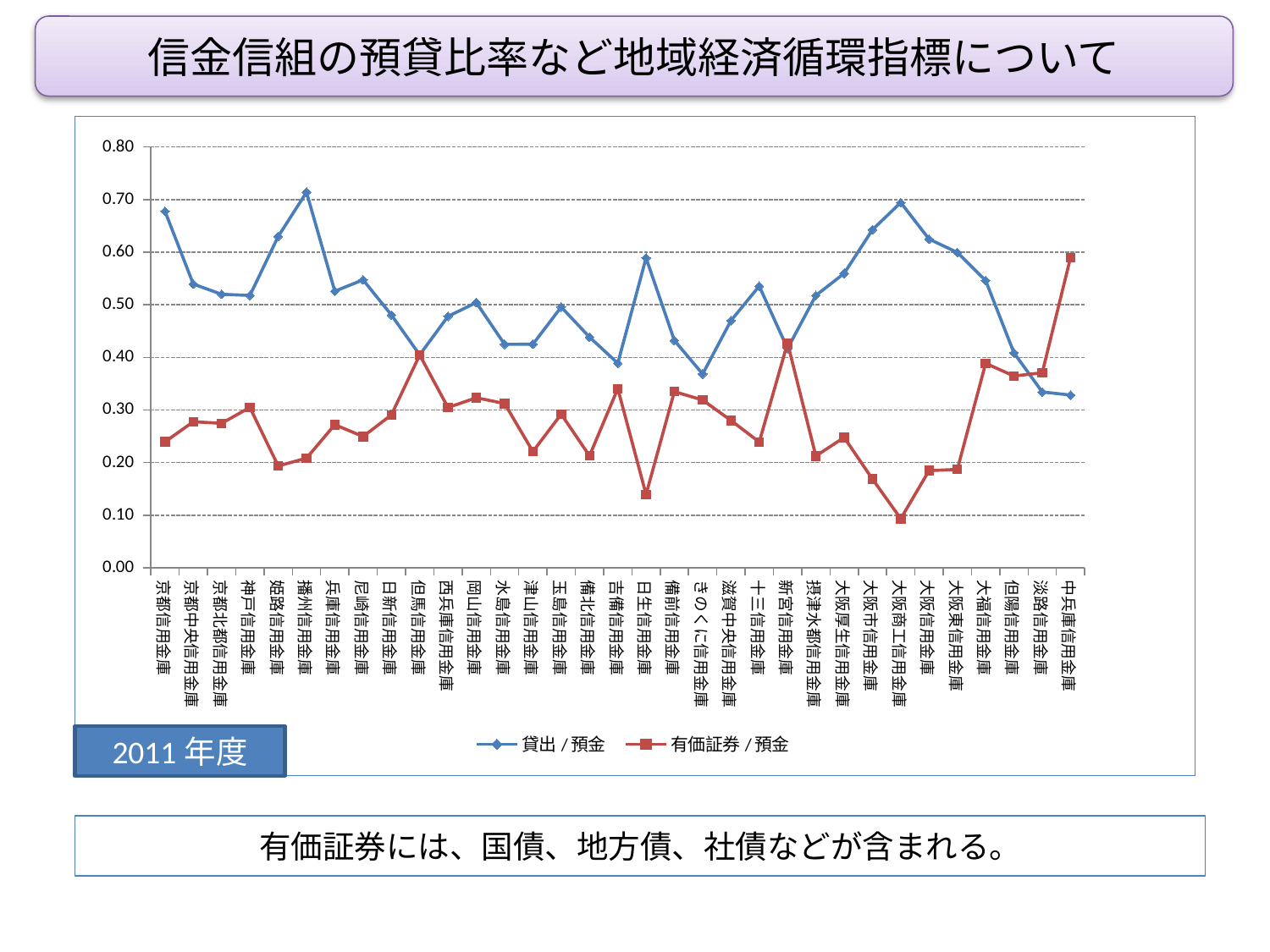
Is the 有価証券/預金 value for 日生信用金庫 greater or less than 0.20? less Is the 貸出/預金 value for 京都信用金庫 greater or less than 0.60? greater What kind of chart is shown on the slide? line chart How many credit unions (categories) are plotted along the x axis? 33 What are the two series named in the legend? 貸出/預金 and 有価証券/預金 Which fiscal year does the chart cover, according to the label on the slide? 2011年度 For 中兵庫信用金庫, which is larger: 貸出/預金 or 有価証券/預金? 有価証券/預金 Is the 貸出/預金 value for 日生信用金庫 greater or less than 0.50? greater Which credit union has the highest 有価証券/預金 value? 中兵庫信用金庫 How many series does the legend list? 2 Which credit union has the lowest 有価証券/預金 value? 大阪商工信用金庫